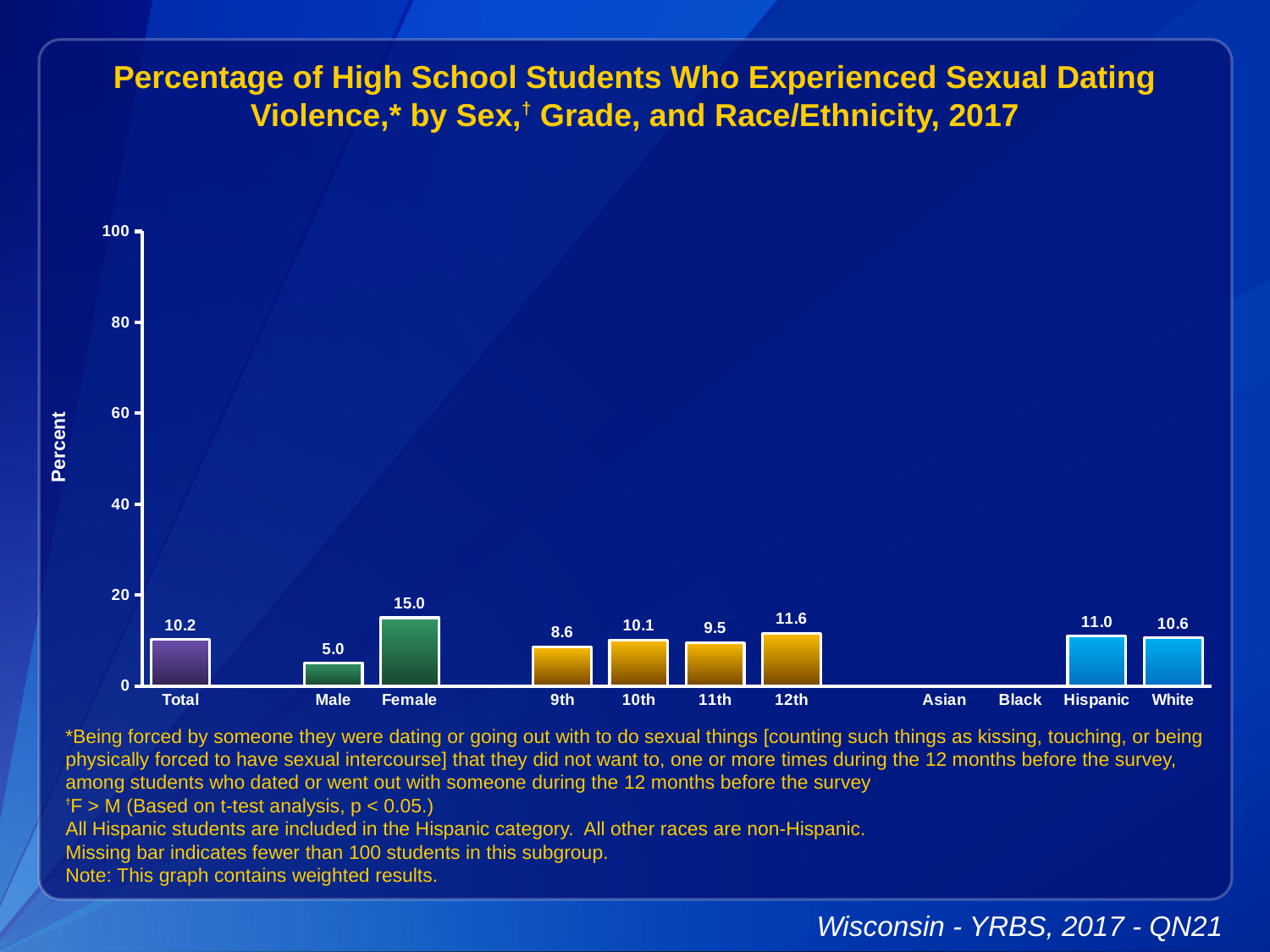
How many categories are labeled on the x axis? 11 What is the value for Total? 10.2 Which is larger, the value for 10th grade or 11th grade? 10th Is the value for Female greater or less than 20? less Which category with a plotted bar has the lowest value? Male What is the value for Female? 15.0 What is the difference between the Female and Male values? 10.0 What is the value for 12th grade? 11.6 What kind of chart is shown? bar chart Which categories have no bar shown? Asian and Black What is the value for Hispanic? 11.0 Which category has the highest value? Female